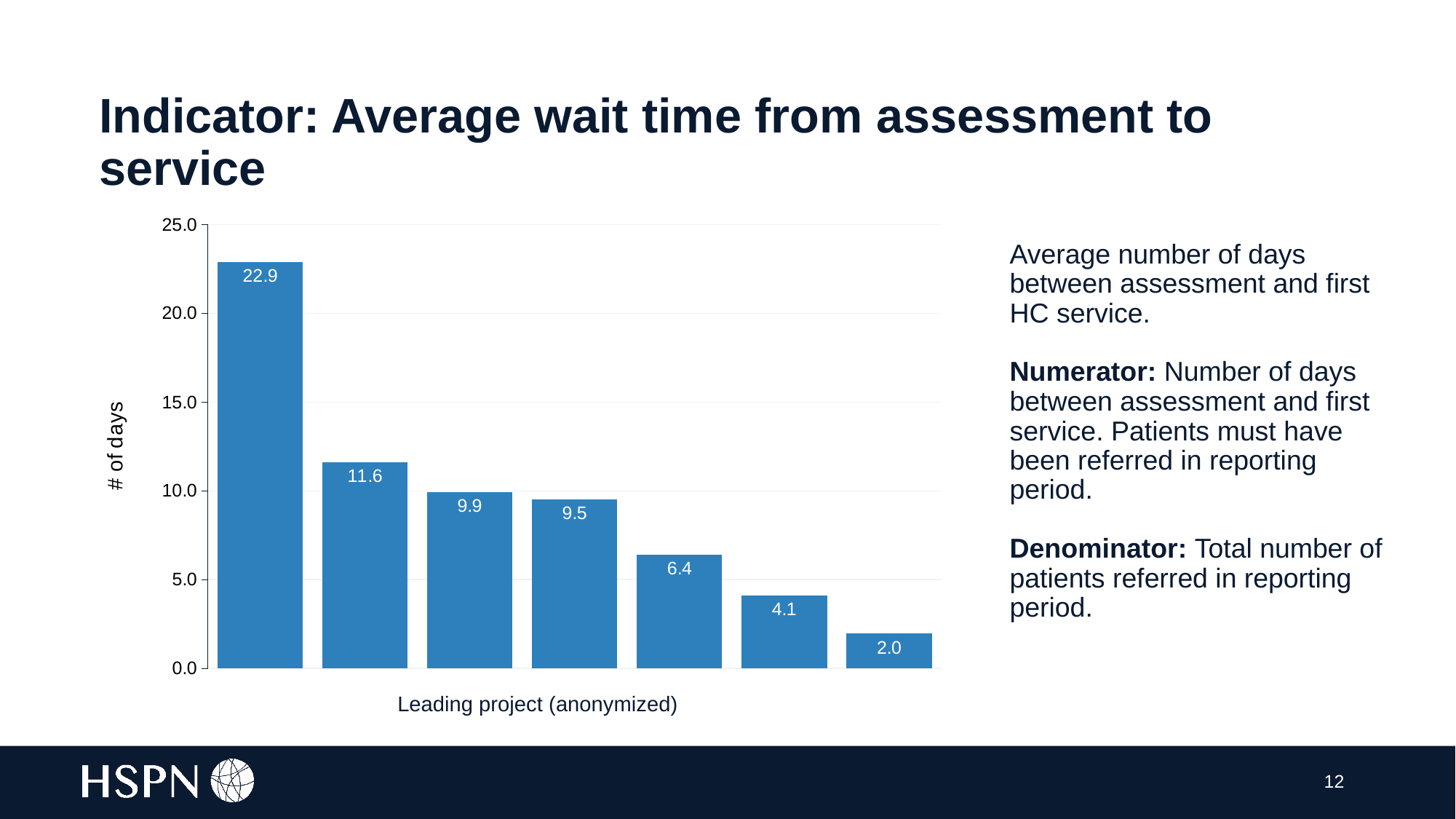
What is the value of the tallest bar in the chart? 22.9 Which is larger, the third bar from the left or the sixth bar from the left? The third bar (9.9) What is the label on the horizontal axis of the chart? Leading project (anonymized) How many bars (projects) are plotted in the chart? 7 What is the label on the vertical axis of the chart? # of days What is the value shown on the fifth bar from the left? 6.4 What type of chart is shown on the slide? Bar chart Do the bar values rise or fall from left to right across the chart? Fall What is the difference between the first bar (22.9) and the second bar (11.6)? 11.3 What is the value of the shortest bar in the chart? 2.0 What is the value shown on the second bar from the left? 11.6 What is the value shown on the fourth bar from the left? 9.5